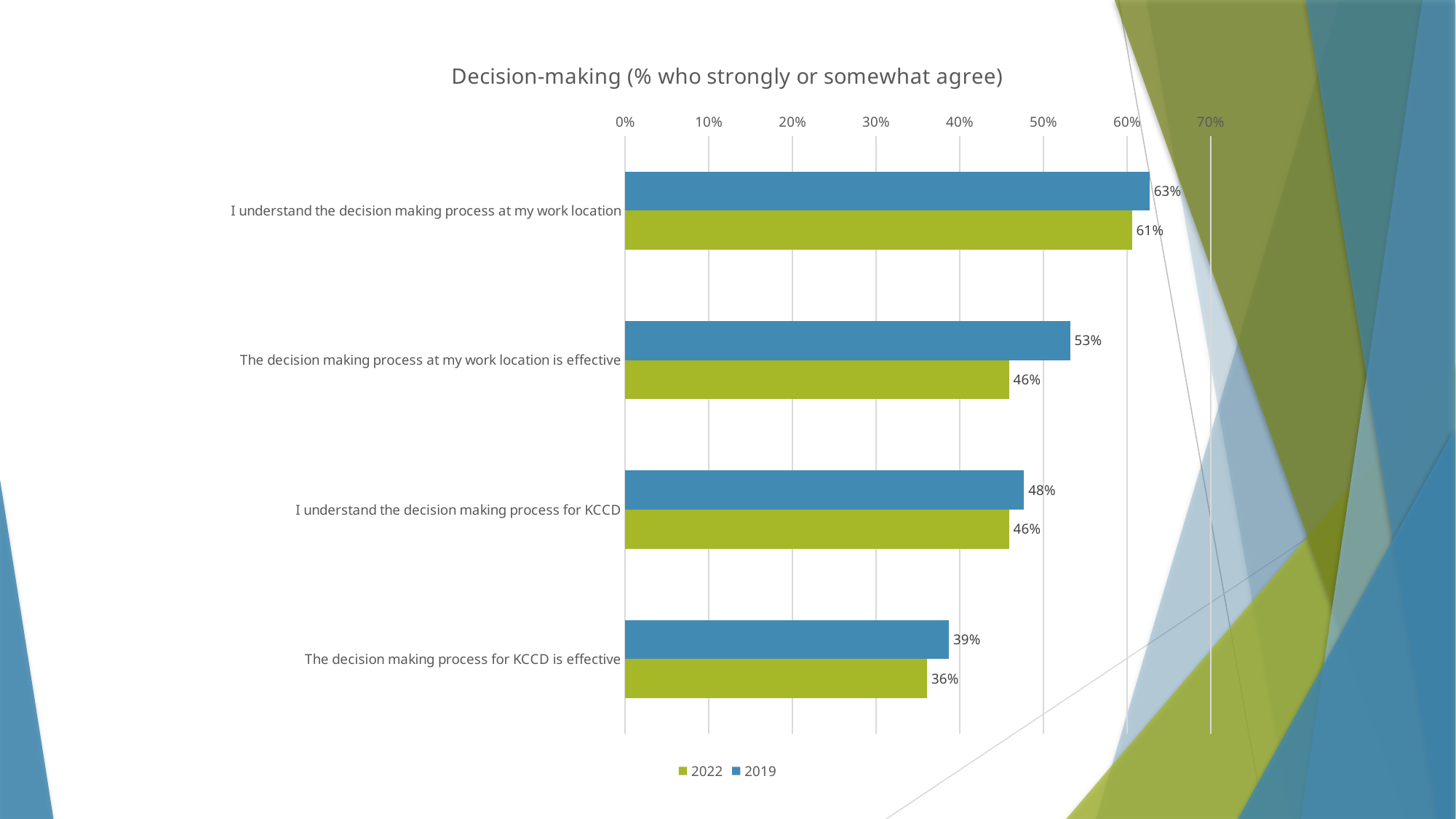
Which is larger for "I understand the decision making process for KCCD": the 2019 value or the 2022 value? 2019 Is the 2019 value for "The decision making process for KCCD is effective" greater or less than 40%? less What is the difference between the 2019 and 2022 values for "The decision making process at my work location is effective"? 7% What is the 2019 value for "I understand the decision making process at my work location"? 63% Which category has the highest 2019 value? I understand the decision making process at my work location How many categories are shown on the chart? 4 What is the 2022 value for "The decision making process for KCCD is effective"? 36% What is the title of the chart? Decision-making (% who strongly or somewhat agree) What kind of chart is shown on the slide? Bar chart Which category has the lowest 2022 value? The decision making process for KCCD is effective How many series does the legend list? 2 What is the 2022 value for "The decision making process at my work location is effective"? 46%